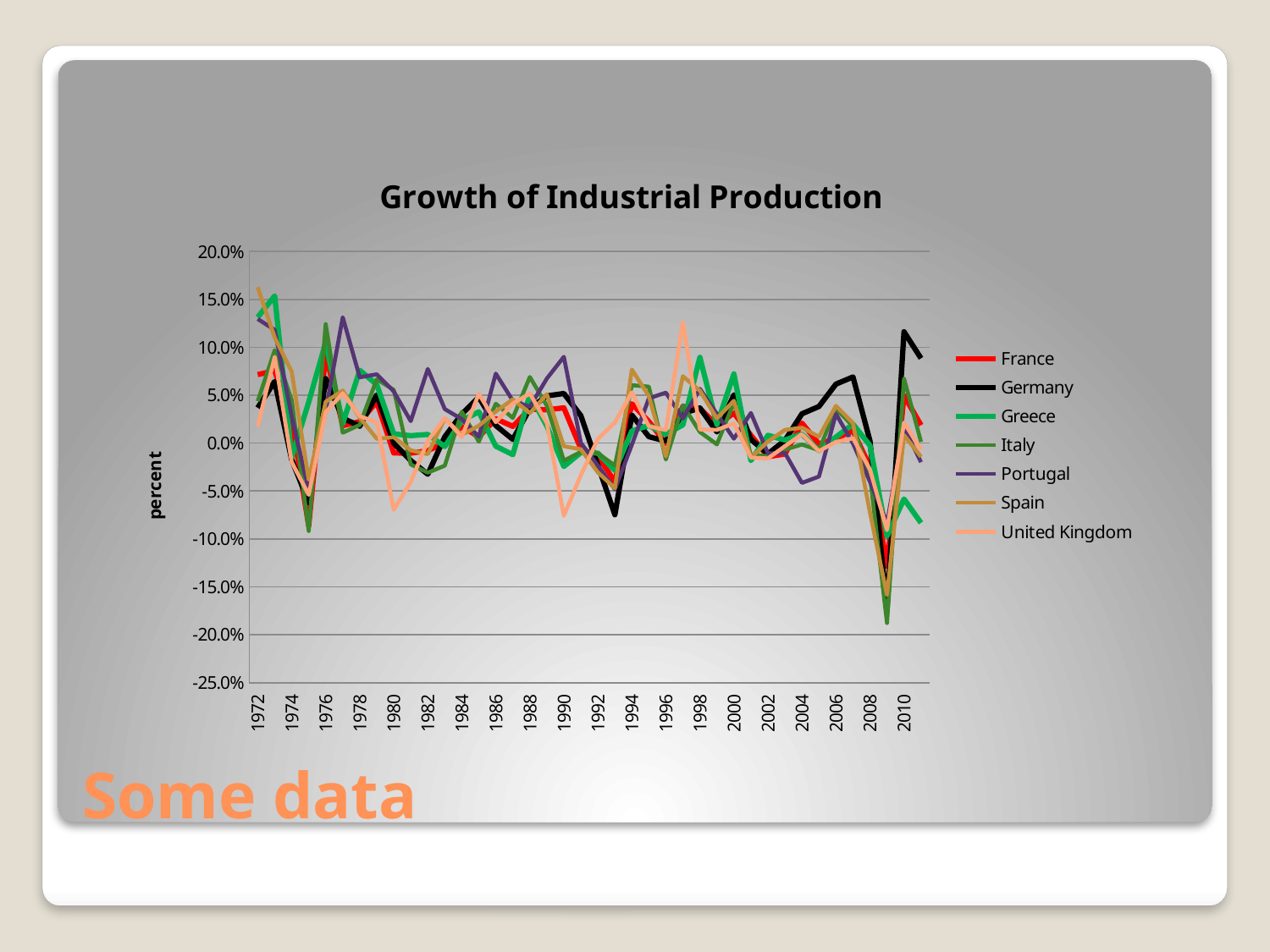
How many series does the legend list? 7 What is the title of the chart? Growth of Industrial Production What is the label on the vertical axis? percent Is the value for Germany in 1993 greater or less than -5.0%? less Which series has the highest value in 2010? Germany Is the value for Germany in 2010 greater or less than 10.0%? greater Which series has the lowest value in 2009? Italy What kind of chart is shown on the slide? line chart Is the value for Germany in 2007 greater or less than 5.0%? greater